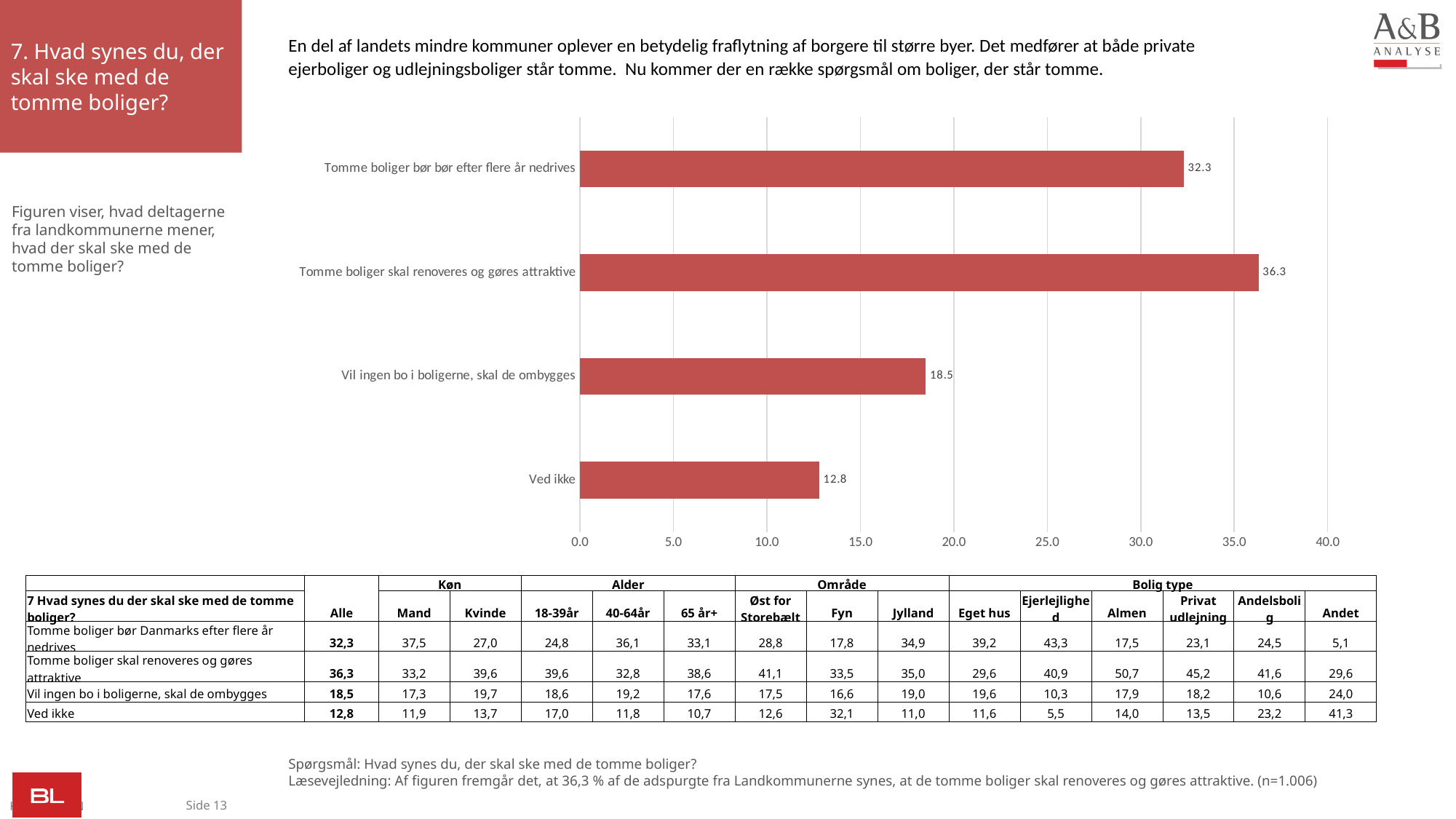
What is the difference between the values for "Tomme boliger skal renoveres og gøres attraktive" and "Tomme boliger bør bør efter flere år nedrives"? 4.0 Which category has the lowest value? Ved ikke Which is larger: the value for "Tomme boliger bør bør efter flere år nedrives" or the value for "Vil ingen bo i boligerne, skal de ombygges"? Tomme boliger bør bør efter flere år nedrives What is the maximum value shown on the chart's horizontal axis? 40.0 What value is shown for "Ved ikke"? 12.8 What is the difference between the values for "Vil ingen bo i boligerne, skal de ombygges" and "Ved ikke"? 5.7 What value is shown for "Vil ingen bo i boligerne, skal de ombygges"? 18.5 Is the value for "Tomme boliger bør bør efter flere år nedrives" greater or less than 30.0? greater How many categories are shown in the chart? 4 What kind of chart is shown on the slide? bar chart What value is shown for "Tomme boliger skal renoveres og gøres attraktive"? 36.3 Which category has the highest value? Tomme boliger skal renoveres og gøres attraktive